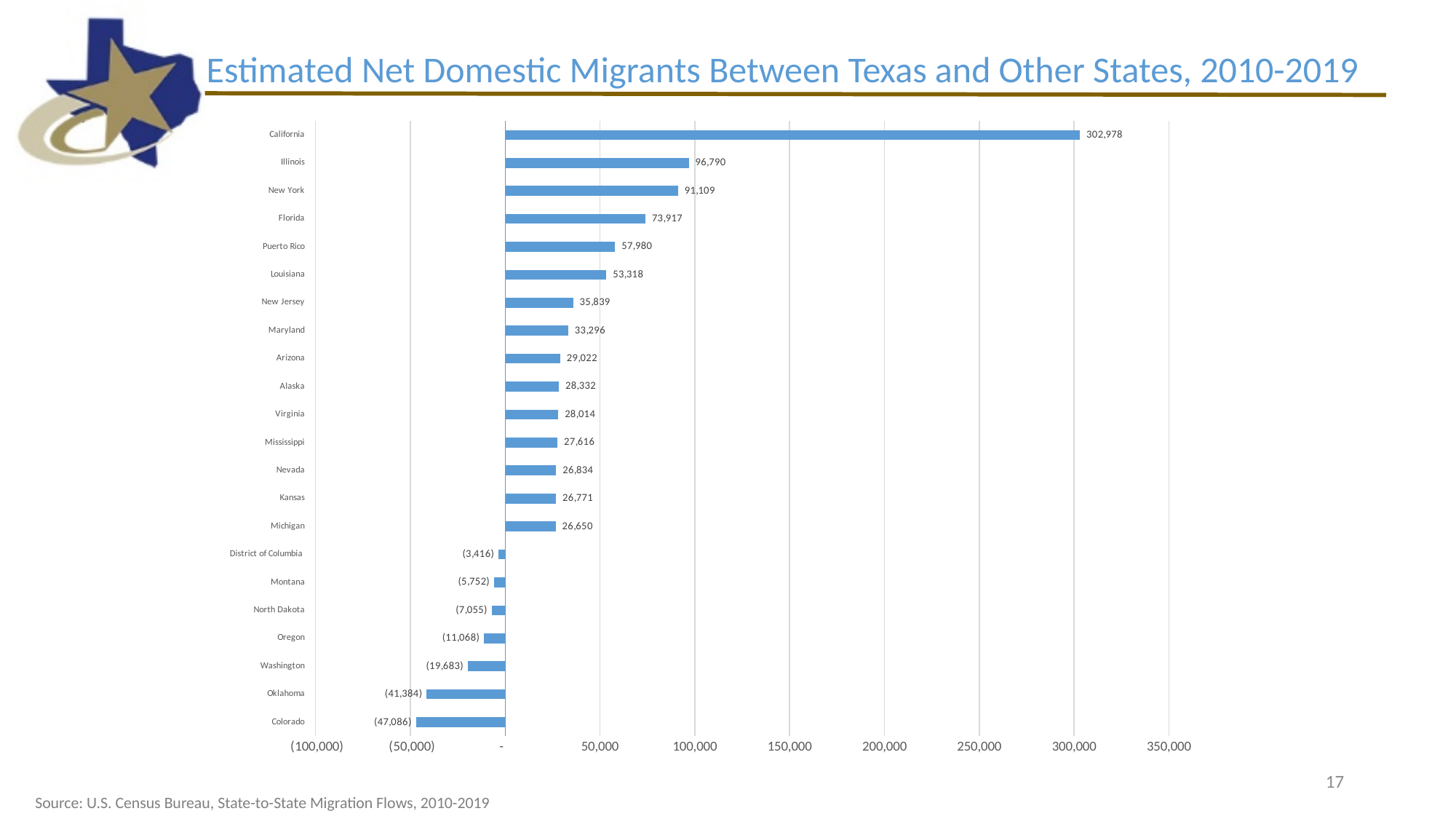
What is the estimated net domestic migration value for California? 302,978 What is the difference between the values for Florida and Puerto Rico? 15,937 Which has a larger value, New York or Florida? New York What is the difference between the values for California and Illinois? 206,188 Is the value for Illinois greater or less than 100,000? less What is the title of the chart? Estimated Net Domestic Migrants Between Texas and Other States, 2010-2019 Which state has the highest net domestic migration to Texas? California How many states or territories are shown on the chart? 22 What kind of chart is shown on the slide? Bar chart What is the value shown for Colorado? (47,086) What is the value shown for Louisiana? 53,318 Which state has the lowest (most negative) value on the chart? Colorado